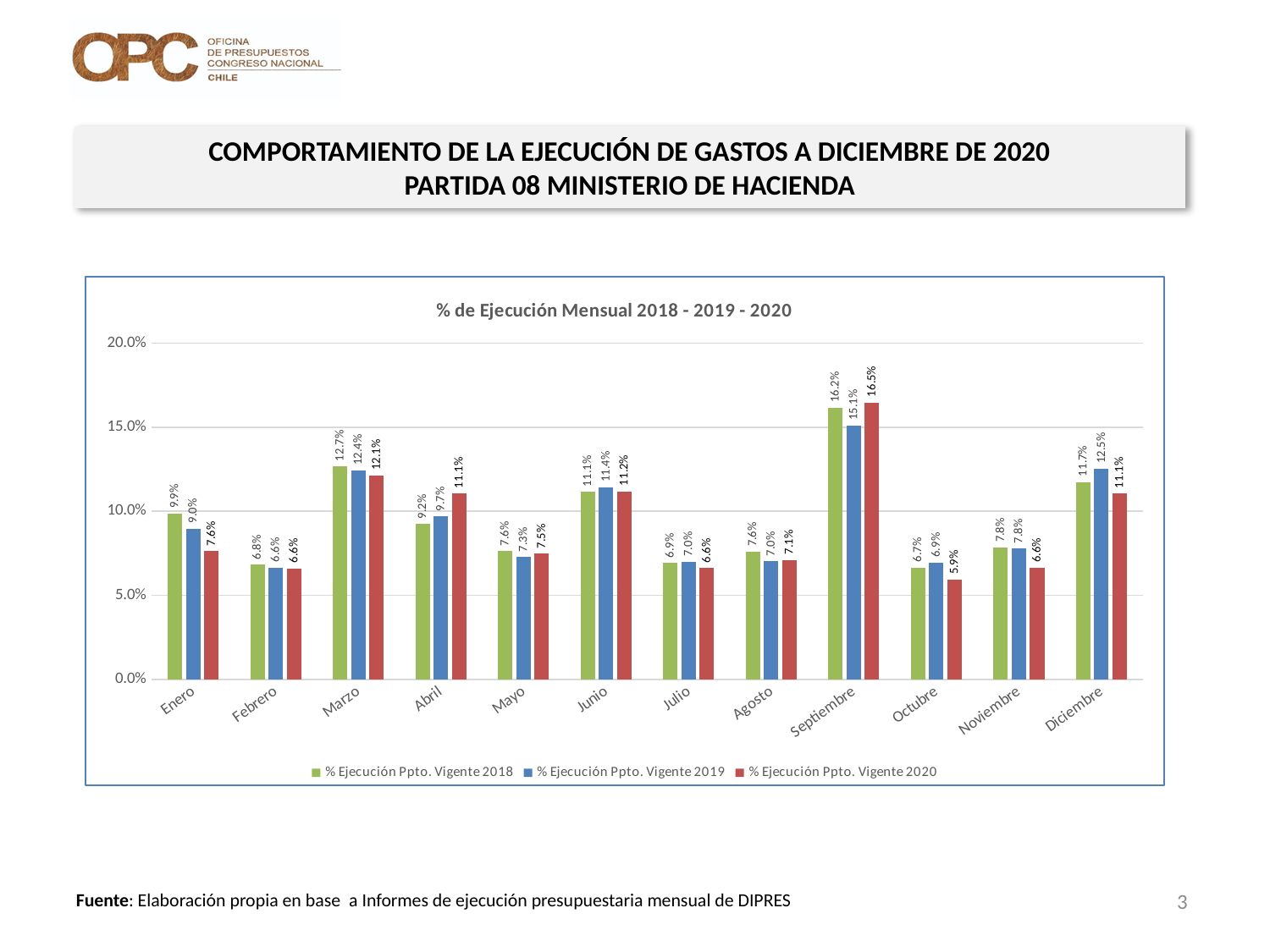
What is the value for % Ejecución Ppto. Vigente 2020 in Septiembre? 16.5% What is the value for % Ejecución Ppto. Vigente 2018 in Marzo? 12.7% How many series does the legend list? 3 What is the title of the chart? % de Ejecución Mensual 2018 - 2019 - 2020 How many months are shown on the x axis? 12 What is the difference between the 2018 and 2020 values in Enero? 2.3% What is the value for % Ejecución Ppto. Vigente 2019 in Diciembre? 12.5% Which month has the lowest value for % Ejecución Ppto. Vigente 2020? Octubre What kind of chart is shown on the slide? Bar chart Which is larger in Abril: the 2018 value or the 2020 value? 2020 value (11.1%) Which month has the highest value for % Ejecución Ppto. Vigente 2020? Septiembre Is the value for % Ejecución Ppto. Vigente 2018 in Septiembre greater or less than 15.0%? greater